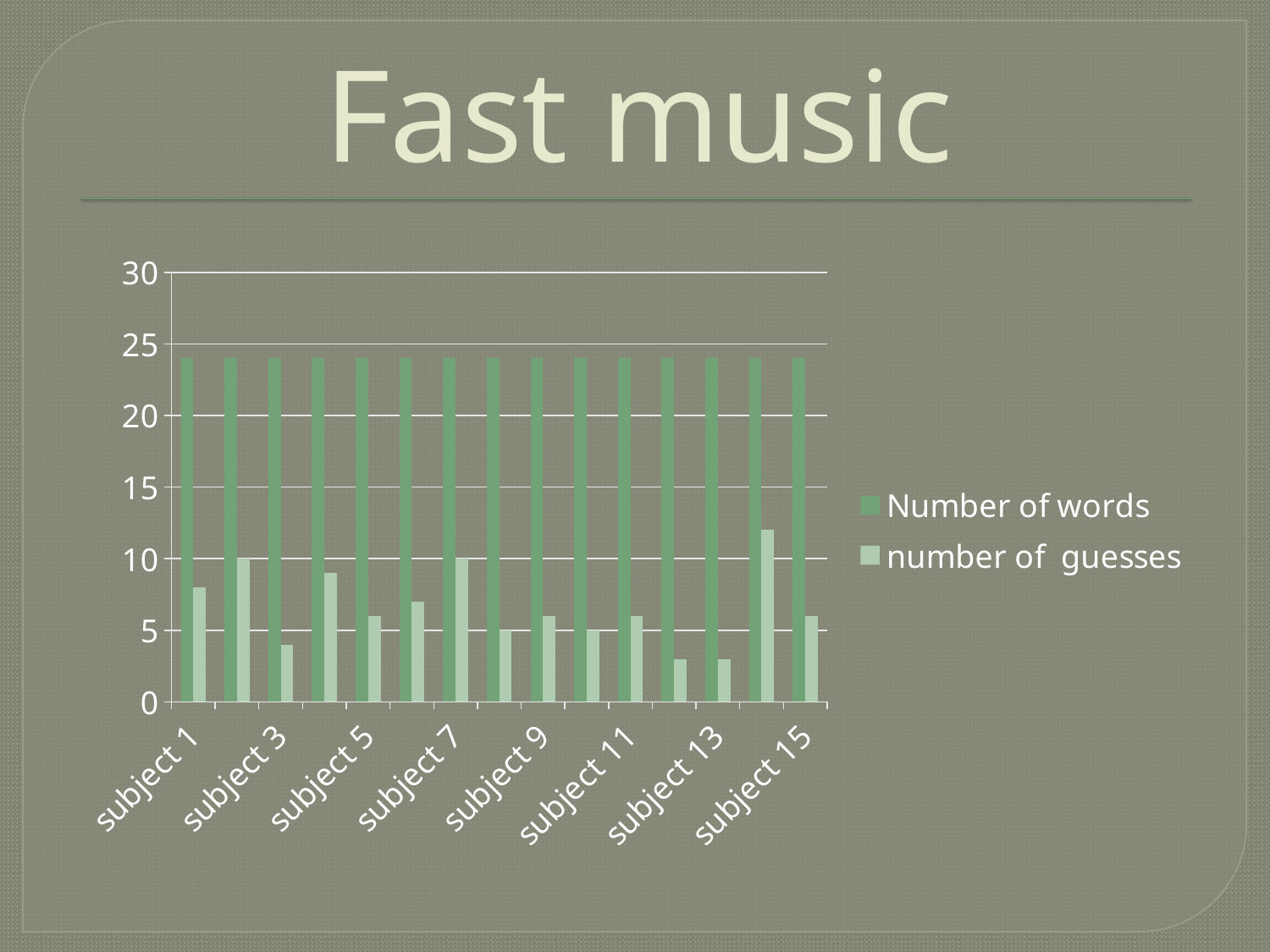
For subject 5, which series has the larger value, Number of words or number of guesses? Number of words How many subjects (categories) are plotted on the x axis? 15 Which has more guesses, subject 1 or subject 3? subject 1 Is the number of guesses for subject 1 greater or less than 5? greater How many series does the legend list? 2 What is the number of guesses for subject 7? 10 Is the number of guesses for subject 13 greater or less than 5? less What kind of chart is shown on the slide? bar chart Which has more guesses, subject 7 or subject 13? subject 7 What is the title of the slide containing the chart? Fast music Is the number of words for subject 9 greater or less than 25? less